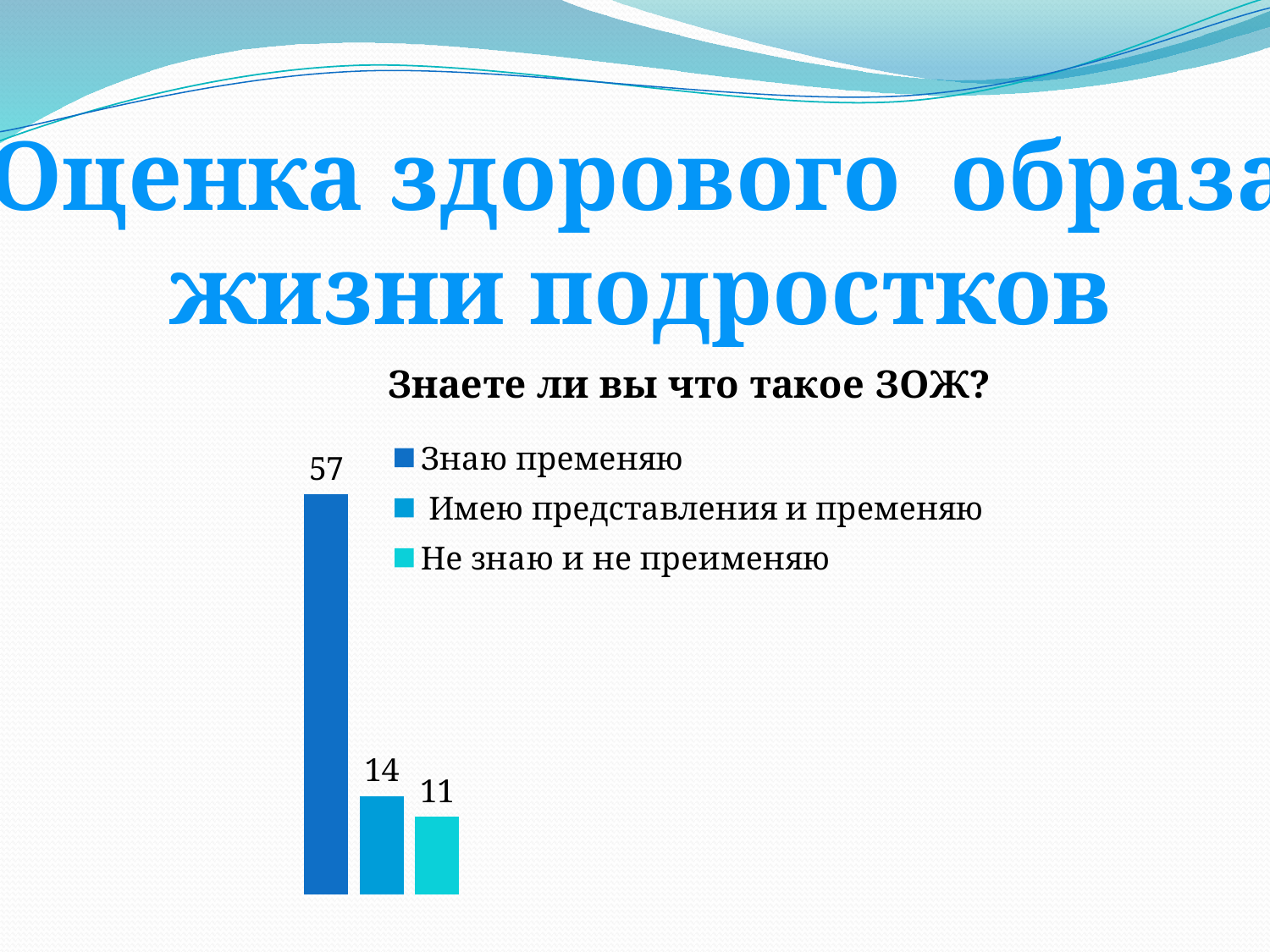
What is the value for "Знаю променяю"? 57 What is the difference between the values for "Знаю променяю" and "Имею представления и променяю"? 43 What is the value for "Имею представления и променяю"? 14 What is the difference between the values for "Имею представления и променяю" and "Не знаю и не преименяю"? 3 What is the title of the chart? Знаете ли вы что такое ЗОЖ? Which series has the highest value? Знаю пременяю How many series does the legend list? 3 Which is larger: the value for "Знаю променяю" or the value for "Не знаю и не преименяю"? Знаю пременяю Which series has the lowest value? Не знаю и не преименяю What is the value for "Не знаю и не преименяю"? 11 What kind of chart is shown on the slide? Bar chart How many bars are plotted in the chart? 3